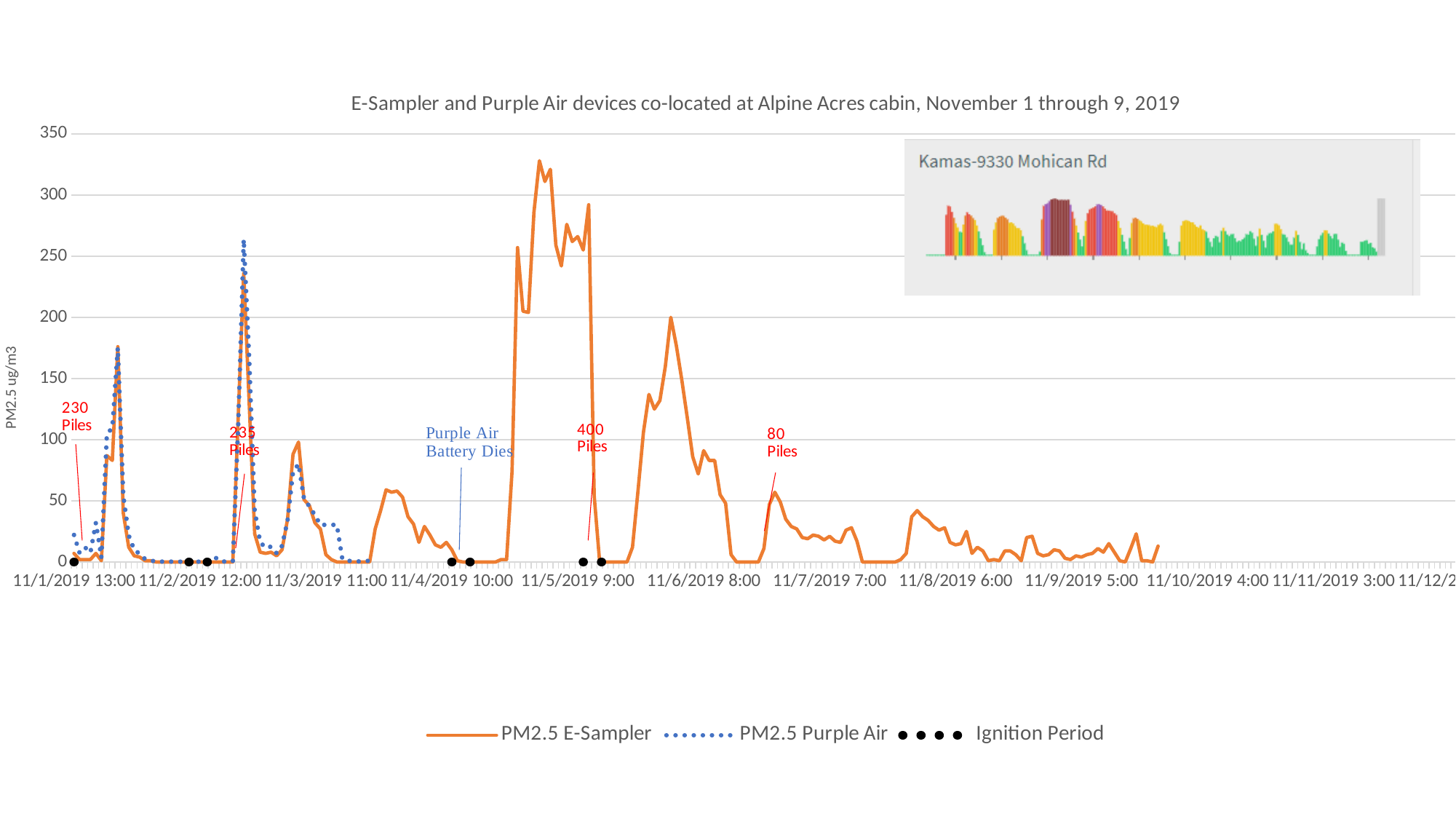
What kind of chart is shown on the slide? line chart Is the first peak of the PM2.5 E-Sampler series, near 11/1/2019 13:00, greater or less than 150? greater How many series does the chart legend list? 3 Is the peak of the PM2.5 Purple Air series near 11/2/2019 12:00 greater or less than 250? greater Which is larger: the PM2.5 E-Sampler peak around 11/5/2019 or the peak around 11/6/2019? the peak around 11/5/2019 Is the highest value of the PM2.5 E-Sampler series, reached around 11/5/2019, greater or less than 300? greater What label is shown on the vertical axis of the chart? PM2.5 ug/m3 Which series is drawn as a blue dotted line in the chart? PM2.5 Purple Air What is the title of the chart? E-Sampler and Purple Air devices co-located at Alpine Acres cabin, November 1 through 9, 2019